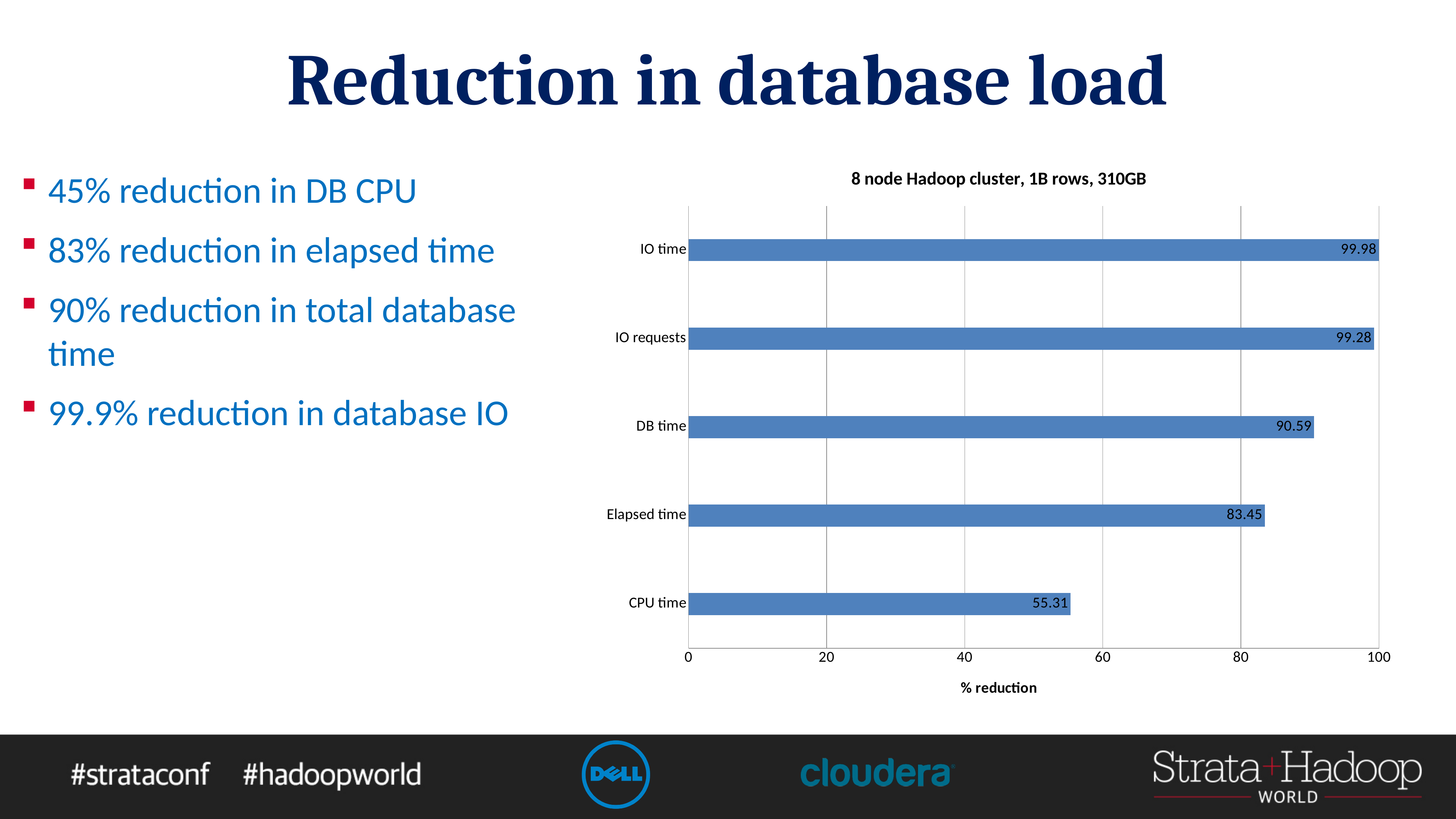
What is the % reduction for Elapsed time? 83.45 Which has a larger % reduction, DB time or Elapsed time? DB time What is the difference in % reduction between DB time and Elapsed time? 7.14 What kind of chart is shown on the slide? Bar chart Which category has the lowest % reduction? CPU time Is the value for CPU time greater or less than 60? less What is the % reduction for IO time? 99.98 What is the % reduction for CPU time? 55.31 What is the difference in % reduction between IO requests and CPU time? 43.97 How many categories are shown in the chart? 5 What is the % reduction for DB time? 90.59 What is the title of the chart? 8 node Hadoop cluster, 1B rows, 310GB